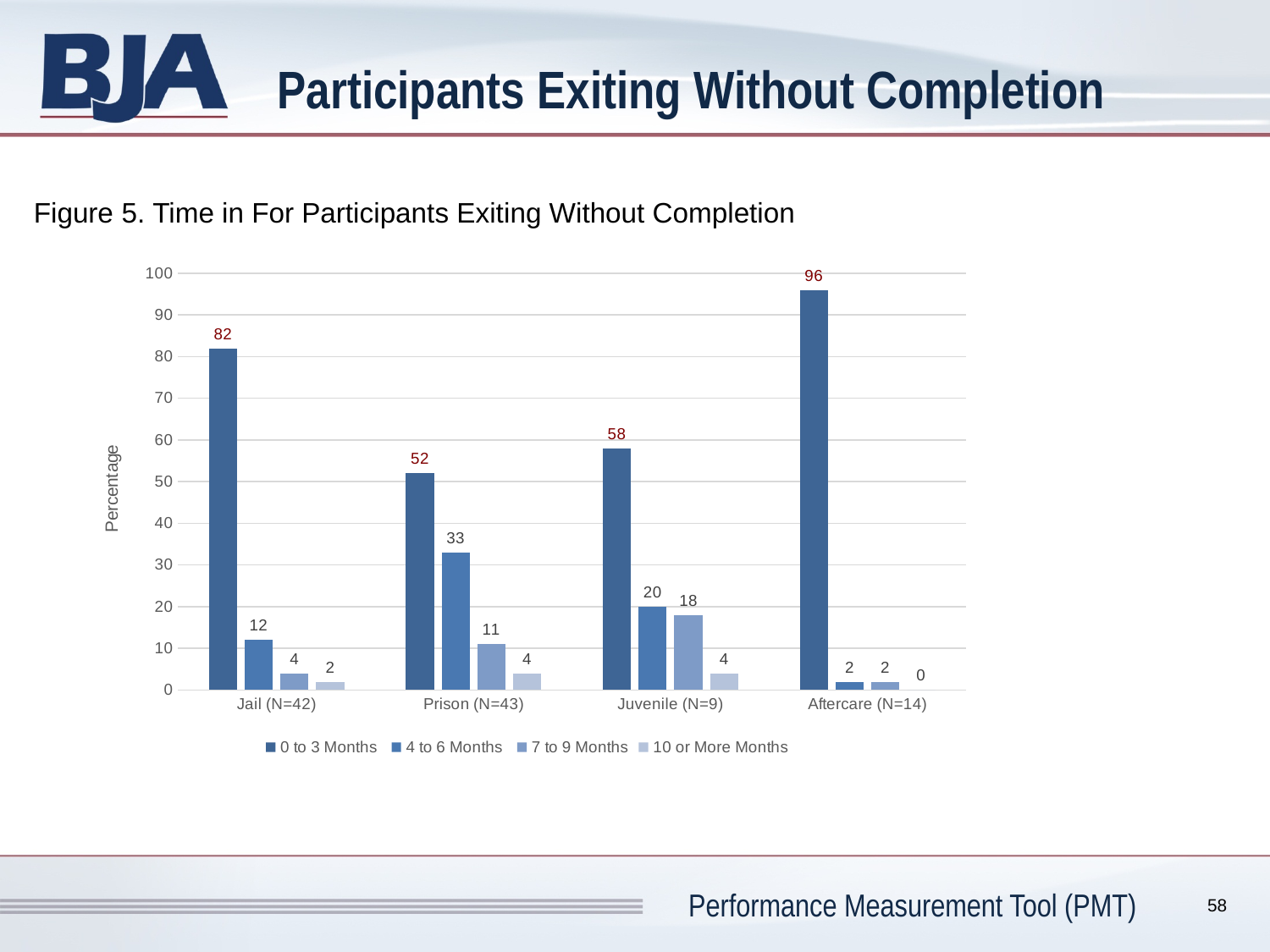
What kind of chart is shown on the slide? Bar chart Which is larger: the 4 to 6 Months value for Prison (N=43) or for Juvenile (N=9)? Prison (N=43) What is the value for 10 or More Months in the Aftercare (N=14) category? 0 How many categories are shown on the x axis? 4 What is the value for 4 to 6 Months in the Prison (N=43) category? 33 Which category has the highest value for 0 to 3 Months? Aftercare (N=14) What is the label of the y axis? Percentage What is the value for 7 to 9 Months in the Juvenile (N=9) category? 18 How many series does the legend list? 4 What is the difference between the 0 to 3 Months values for Aftercare (N=14) and Jail (N=42)? 14 Which category has the lowest value for 0 to 3 Months? Prison (N=43) What is the value for 0 to 3 Months in the Jail (N=42) category? 82